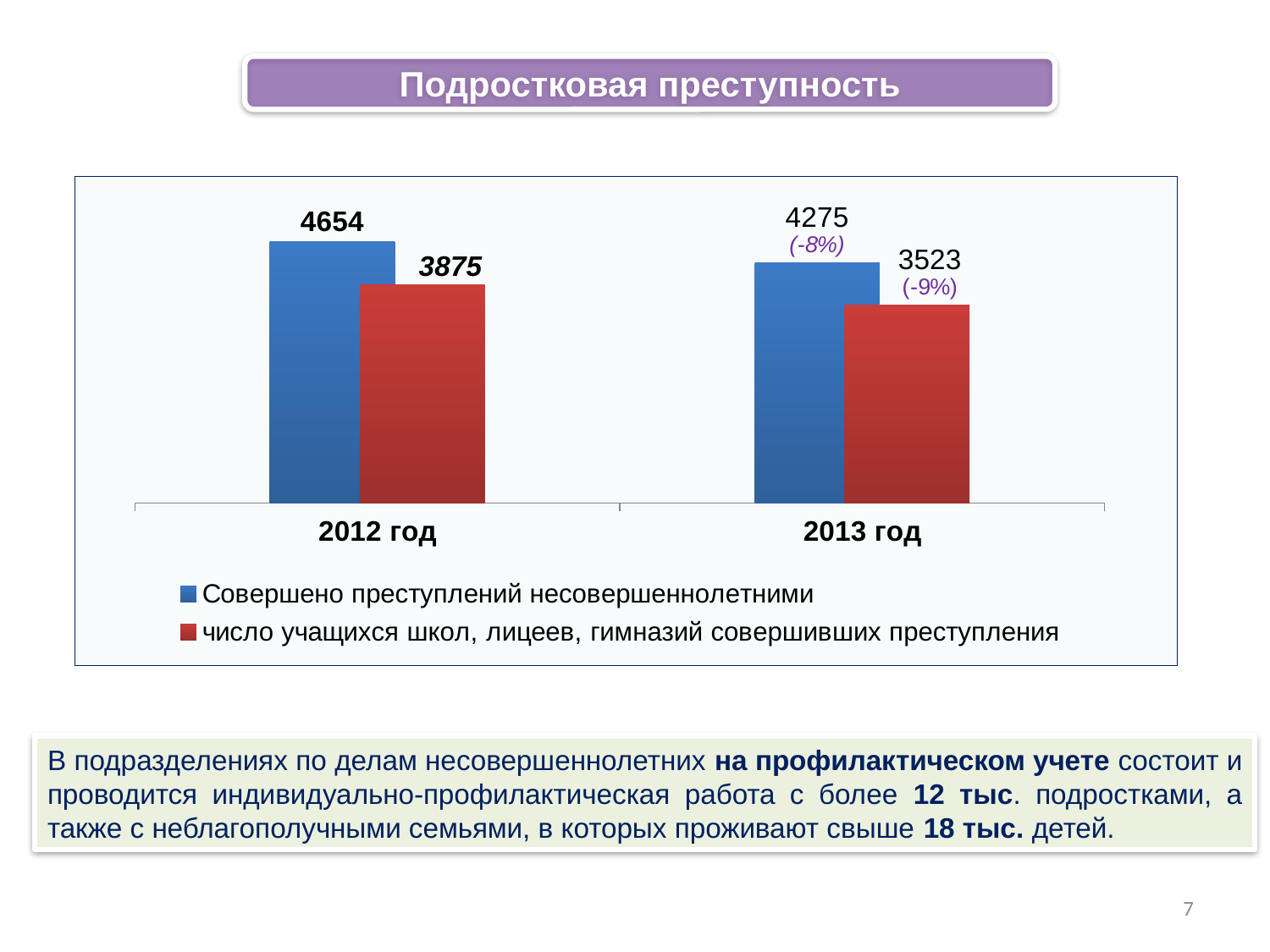
What is the value for 'Совершено преступлений несовершеннолетними' in 2012 год? 4654 What is the difference between the two series in 2013 год? 752 Do the values for 'число учащихся школ, лицеев, гимназий совершивших преступления' rise or fall from 2012 год to 2013 год? fall What is the value for 'Совершено преступлений несовершеннолетними' in 2013 год? 4275 How many series does the legend list? 2 By how much did 'Совершено преступлений несовершеннолетними' change from 2012 год to 2013 год? decreased by 379 How many categories are shown on the x axis? 2 Which series has the lower value in 2012 год? число учащихся школ, лицеев, гимназий совершивших преступления Which year has the higher value for 'Совершено преступлений несовершеннолетними'? 2012 год What is the value for 'число учащихся школ, лицеев, гимназий совершивших преступления' in 2012 год? 3875 What kind of chart is shown on the slide? bar chart What is the value for 'число учащихся школ, лицеев, гимназий совершивших преступления' in 2013 год? 3523